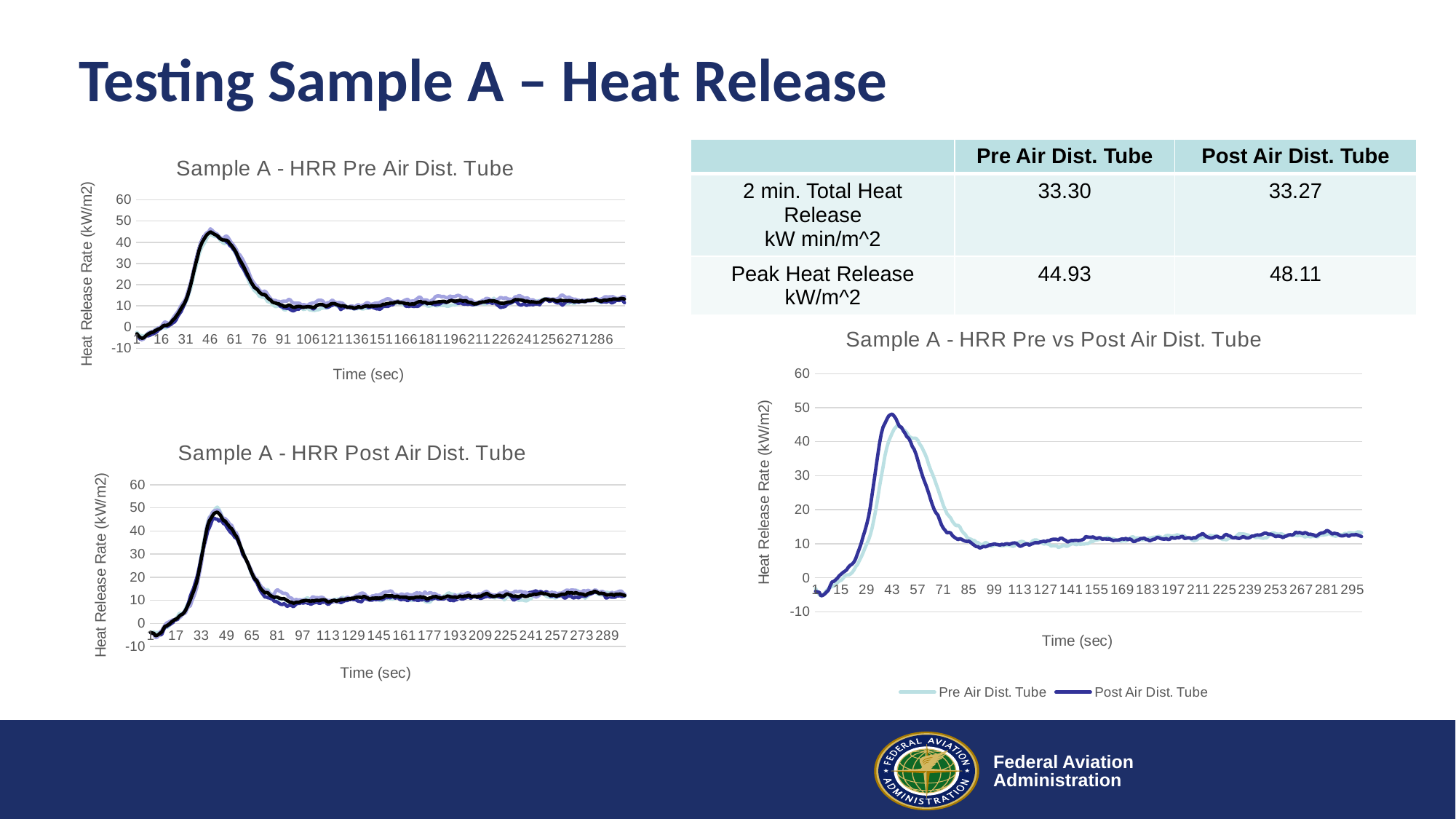
In "Sample A - HRR Pre vs Post Air Dist. Tube", is the value of the Post Air Dist. Tube series at time 295 greater or less than 20? less In "Sample A - HRR Pre vs Post Air Dist. Tube", does the Post Air Dist. Tube series rise or fall between time 1 and time 43? rise In "Sample A - HRR Pre Air Dist. Tube", does the curve rise or fall between time 46 and time 91? fall In "Sample A - HRR Pre Air Dist. Tube", is the peak value of the curve greater or less than 50? less What is the y-axis label of "Sample A - HRR Pre vs Post Air Dist. Tube"? Heat Release Rate (kW/m2) In "Sample A - HRR Pre Air Dist. Tube", is the peak value of the curve greater or less than 40? greater In "Sample A - HRR Pre vs Post Air Dist. Tube", what are the two series named in the legend? Pre Air Dist. Tube and Post Air Dist. Tube In "Sample A - HRR Pre vs Post Air Dist. Tube", which series reaches the higher peak, Pre Air Dist. Tube or Post Air Dist. Tube? Post Air Dist. Tube How many charts are shown on the slide? 3 What kind of chart is "Sample A - HRR Pre Air Dist. Tube"? line chart How many series does the legend of "Sample A - HRR Pre vs Post Air Dist. Tube" list? 2